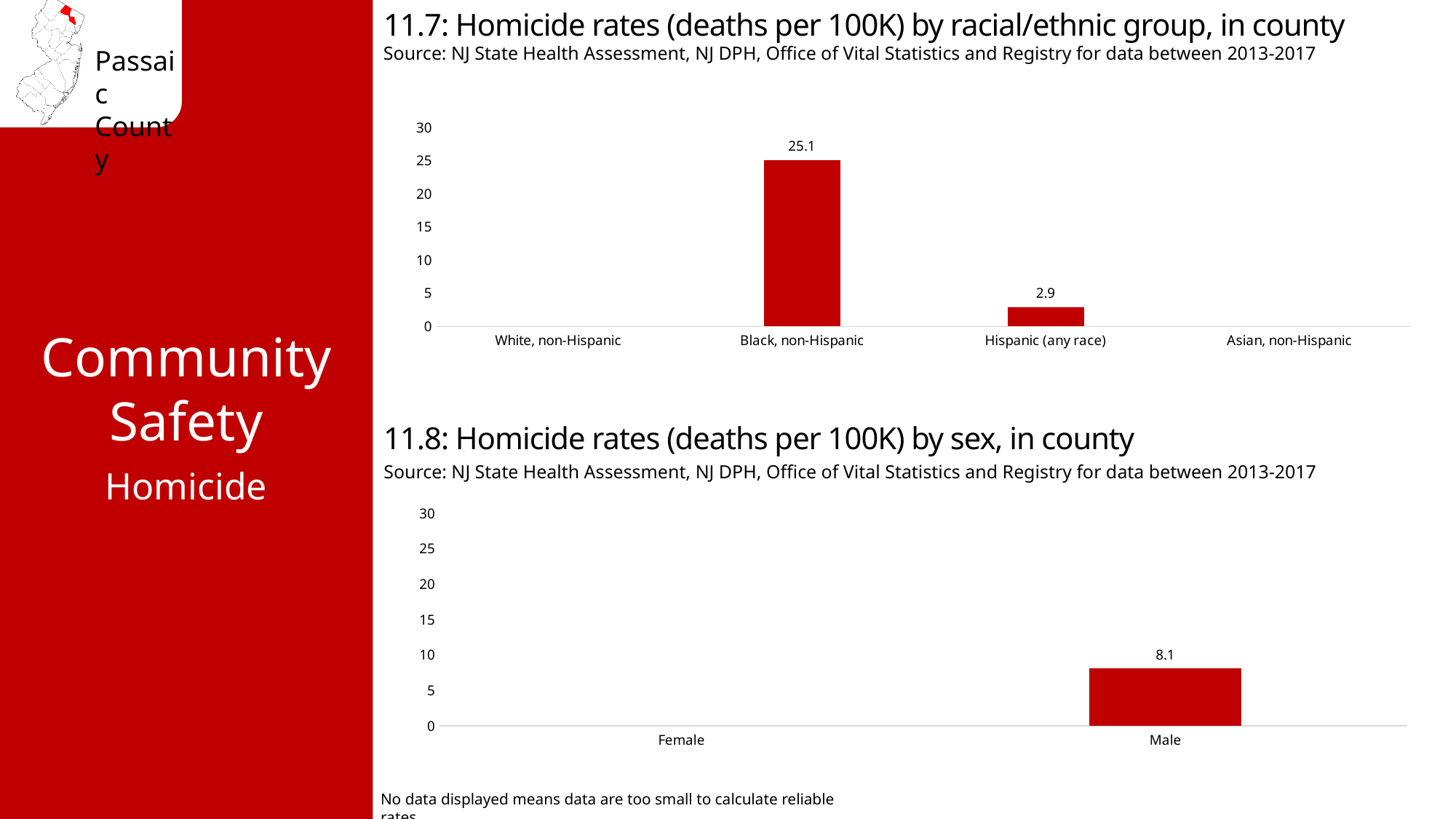
In the chart '11.7: Homicide rates (deaths per 100K) by racial/ethnic group, in county', which group has the highest homicide rate? Black, non-Hispanic In the chart '11.8: Homicide rates (deaths per 100K) by sex, in county', is the value for Male greater or less than 10? less In the chart '11.7: Homicide rates (deaths per 100K) by racial/ethnic group, in county', what is the difference between the rates for Black, non-Hispanic and Hispanic (any race)? 22.2 In the chart '11.7: Homicide rates (deaths per 100K) by racial/ethnic group, in county', which categories have no bar displayed? White, non-Hispanic and Asian, non-Hispanic What kind of chart is '11.8: Homicide rates (deaths per 100K) by sex, in county'? Bar chart In the chart '11.7: Homicide rates (deaths per 100K) by racial/ethnic group, in county', is the value for Black, non-Hispanic greater or less than 20? greater In the chart '11.8: Homicide rates (deaths per 100K) by sex, in county', how many categories are shown on the x axis? 2 In the chart '11.7: Homicide rates (deaths per 100K) by racial/ethnic group, in county', what is the homicide rate for Black, non-Hispanic? 25.1 In the chart '11.8: Homicide rates (deaths per 100K) by sex, in county', what is the homicide rate for Male? 8.1 In the chart '11.7: Homicide rates (deaths per 100K) by racial/ethnic group, in county', what is the homicide rate for Hispanic (any race)? 2.9 Which is larger: the Male rate in chart 11.8 or the Hispanic (any race) rate in chart 11.7? Male rate in chart 11.8 In the chart '11.7: Homicide rates (deaths per 100K) by racial/ethnic group, in county', how many racial/ethnic group categories are shown on the x axis? 4